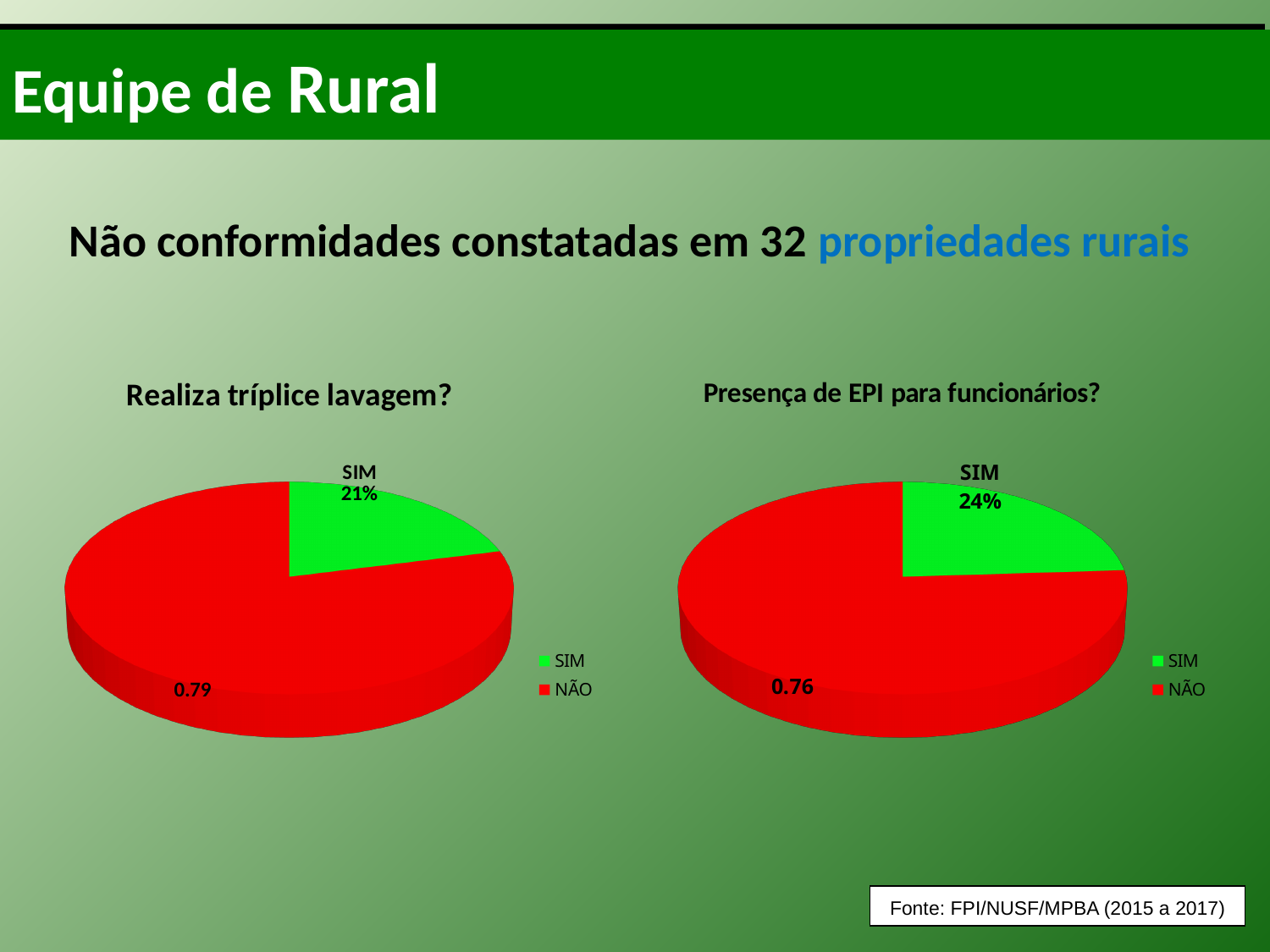
In the chart titled "Presença de EPI para funcionários?", what is the value shown for NÃO? 0.76 In the chart titled "Realiza tríplice lavagem?", which slice is the largest? NÃO How many slices does the chart titled "Realiza tríplice lavagem?" have? 2 What kind of chart is the chart titled "Presença de EPI para funcionários?"? Pie chart In the chart titled "Presença de EPI para funcionários?", what colour is the NÃO slice? Red What is the title of the pie chart on the left side of the slide? Realiza tríplice lavagem? In the chart titled "Presença de EPI para funcionários?", which slice is the smallest? SIM In the chart titled "Realiza tríplice lavagem?", which slice is larger, SIM or NÃO? NÃO In the chart titled "Realiza tríplice lavagem?", what is the value shown for SIM? 21% In the chart titled "Realiza tríplice lavagem?", what is the value shown for NÃO? 0.79 In the chart titled "Presença de EPI para funcionários?", what is the value shown for SIM? 24% How many entries does the legend of the chart titled "Presença de EPI para funcionários?" list? 2